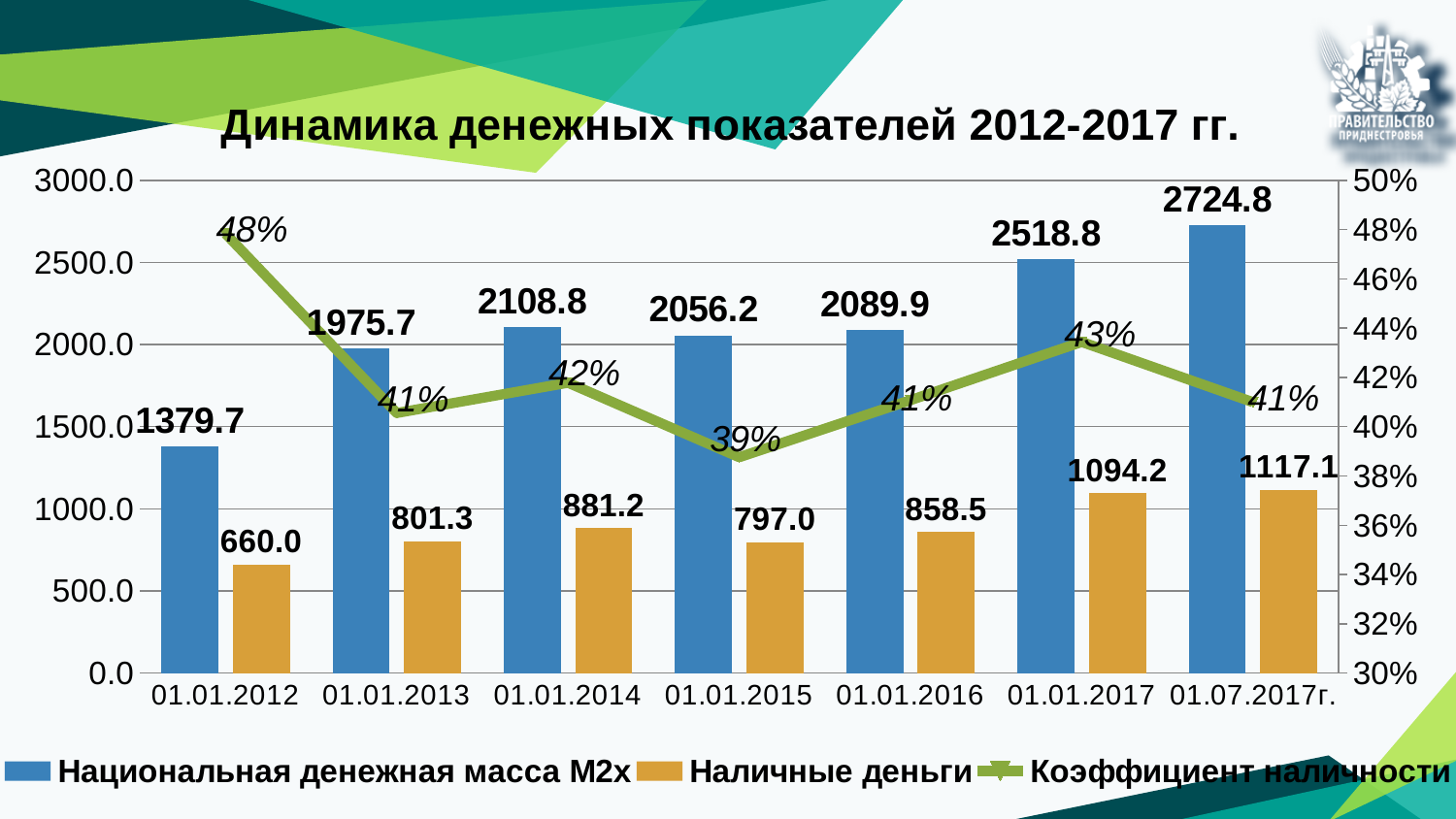
What is the Коэффициент наличности on 01.01.2015? 39% What is the difference between Национальная денежная масса M2x on 01.07.2017г. and on 01.01.2017? 206.0 On which date is Наличные деньги the lowest? 01.01.2012 What is the value of Национальная денежная масса M2x on 01.01.2014? 2108.8 How many series does the legend list? 3 How many dates are shown on the x axis? 7 Which is larger: Наличные деньги on 01.01.2014 or on 01.01.2015? 01.01.2014 On which date is Национальная денежная масса M2x the highest? 01.07.2017г. What is the value of Наличные деньги on 01.01.2017? 1094.2 What kind of chart is this? Combined bar and line chart What is the title of the chart? Динамика денежных показателей 2012-2017 гг. On which date is the Коэффициент наличности the highest? 01.01.2012